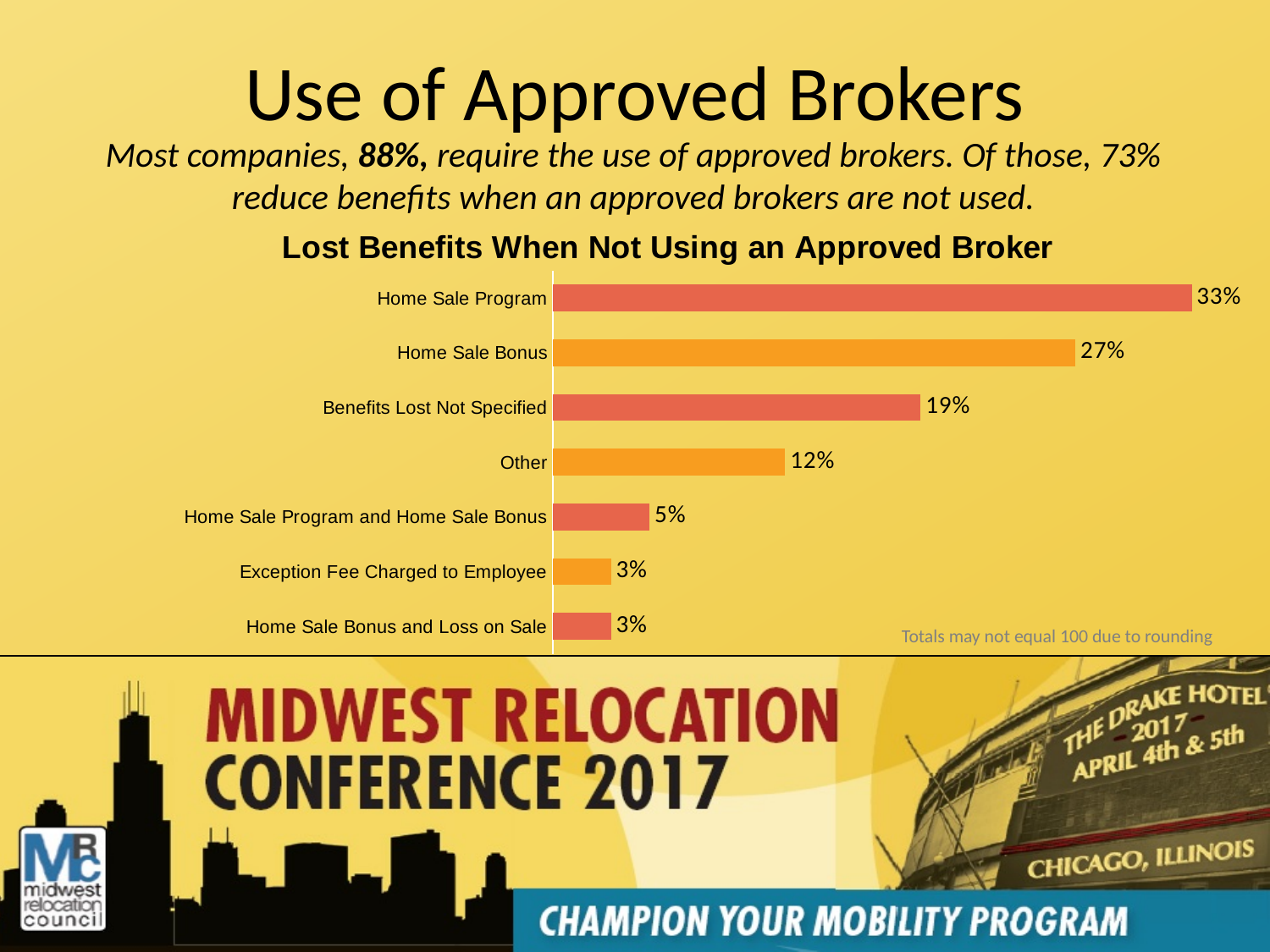
How many categories are shown in the chart? 7 What kind of chart is shown? Bar chart Which is larger, Other or Home Sale Program and Home Sale Bonus? Other What is the value for Home Sale Bonus? 27% What is the difference between Home Sale Program and Home Sale Bonus? 6% What is the value for Benefits Lost Not Specified? 19% What is the value for Exception Fee Charged to Employee? 3% Which category has the highest value? Home Sale Program What is the title of the chart? Lost Benefits When Not Using an Approved Broker What is the value for Other? 12% What is the difference between Benefits Lost Not Specified and Other? 7% What is the value for Home Sale Program? 33%